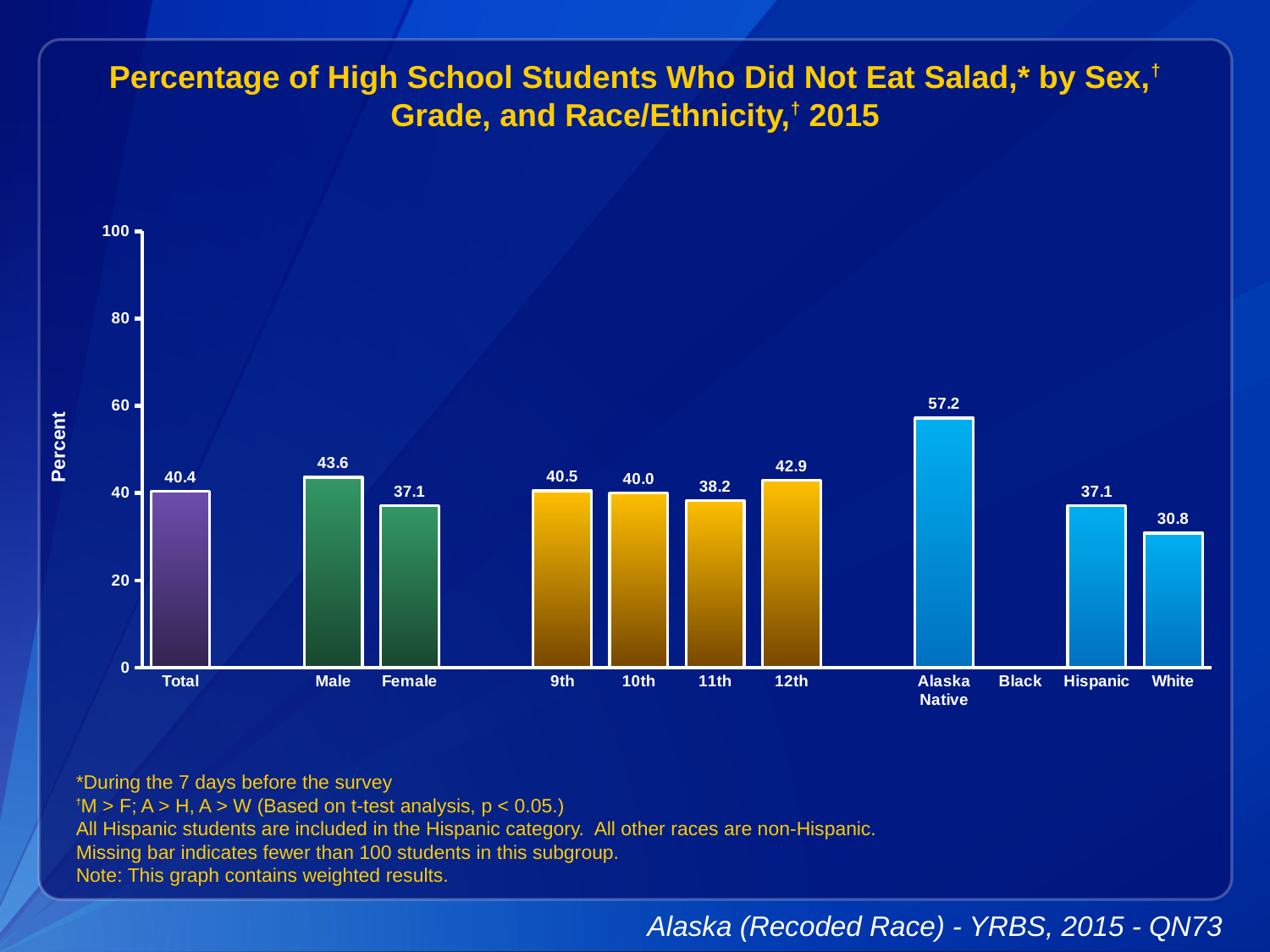
Which is larger, the value for 12th grade or the value for 9th grade? 12th How many bars are plotted on the chart? 10 What is the value for Male? 43.6 Which category has the lowest plotted value? White Which category label on the x axis has no bar plotted? Black What is the difference between the Alaska Native and White values? 26.4 What kind of chart is shown on the slide? bar chart What is the value for 11th grade? 38.2 Is the value for Alaska Native greater or less than 60? less Which category has the highest value? Alaska Native What is the value for Alaska Native? 57.2 What is the difference between the Male and Female values? 6.5